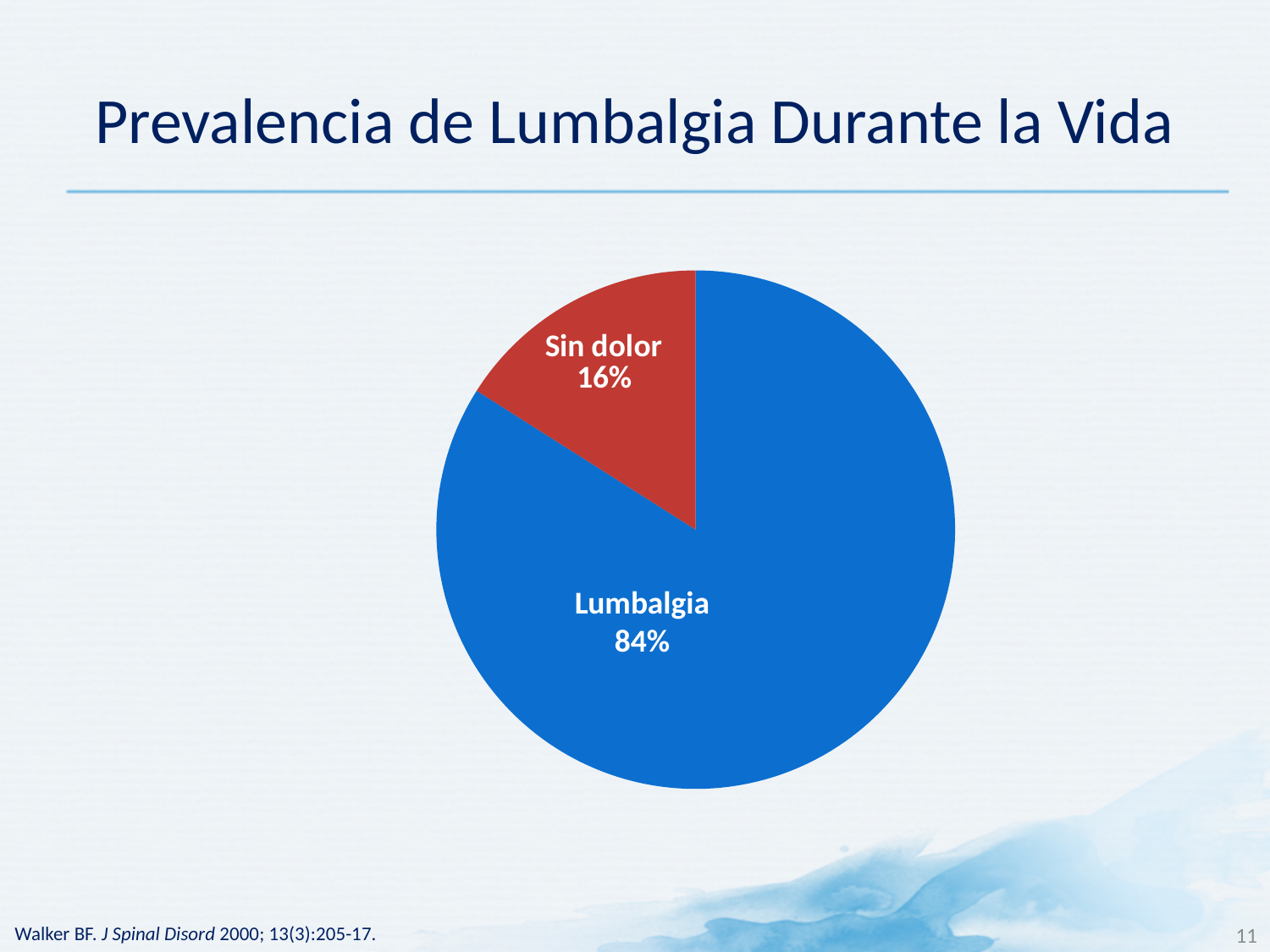
What kind of chart is shown on the slide? pie chart What is the difference in percentage points between the Lumbalgia and Sin dolor slices? 68 What share of the pie does the Sin dolor slice represent? 16% What colour is the Sin dolor slice? red Is the share for Sin dolor greater or less than 50%? less Which slice of the pie is the largest? Lumbalgia What is the total of the two slices' percentages? 100% What is the title of the slide containing the pie chart? Prevalencia de Lumbalgia Durante la Vida How many slices does the pie chart have? 2 Which is larger, the Lumbalgia slice or the Sin dolor slice? Lumbalgia What share of the pie does the Lumbalgia slice represent? 84% Which slice of the pie is the smallest? Sin dolor